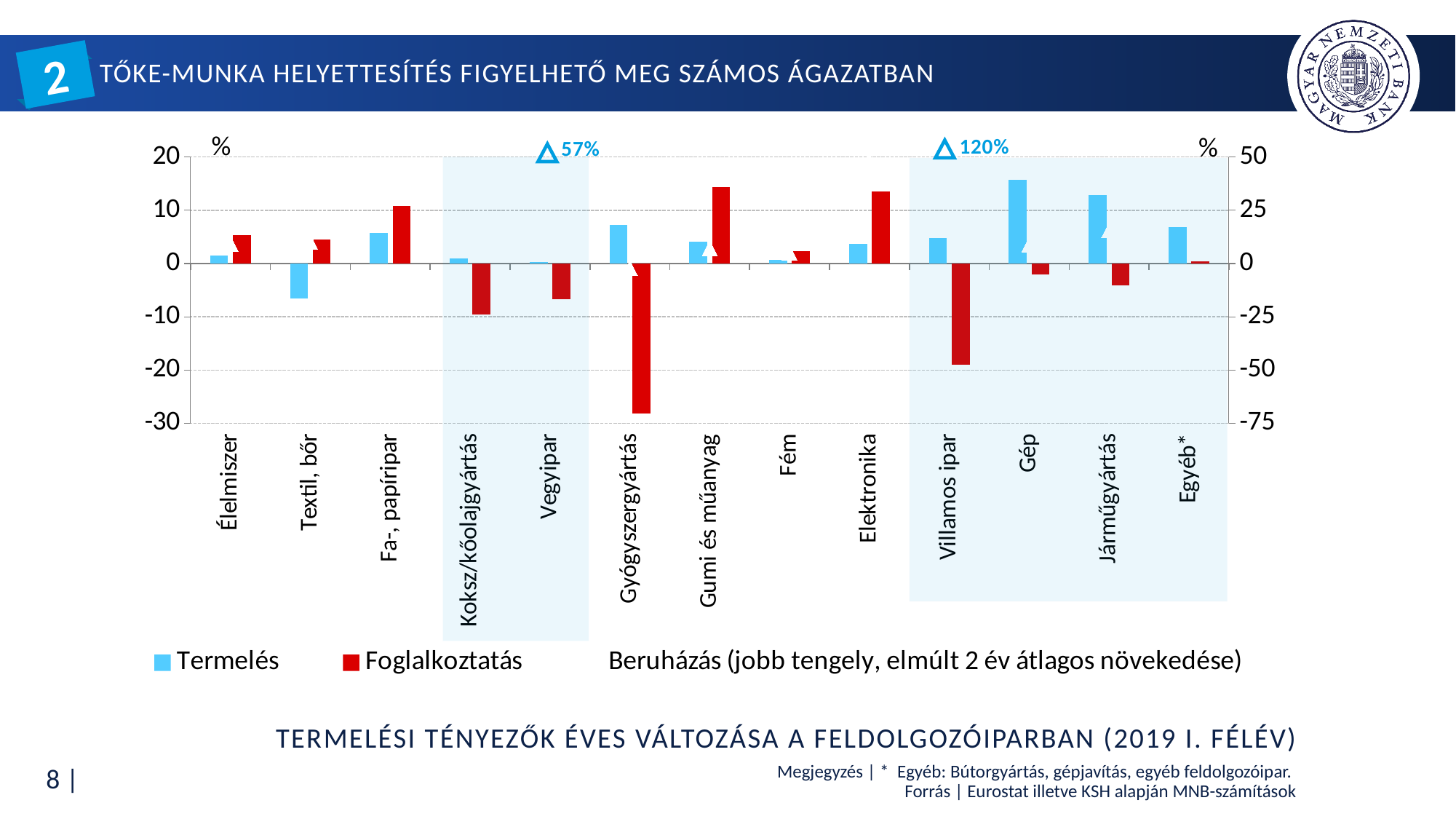
Is the Termelés value for Gép greater or less than 10? greater How many series does the legend list? 3 What kind of chart is shown on the slide? Bar chart Which category has the highest Termelés value? Gép Which category has the lowest Foglalkoztatás value? Gyógyszergyártás What is the Beruházás value shown for Villamos ipar? 120% What is the difference between the Beruházás values labelled for Villamos ipar and Vegyipar? 63 percentage points What is the Beruházás value shown for Vegyipar? 57% Is the Foglalkoztatás value for Gyógyszergyártás greater or less than -20? less Which is larger: the Termelés value for Gép or for Járműgyártás? Gép Which category has the lowest Termelés value? Textil, bőr How many industry categories are shown on the x axis? 13